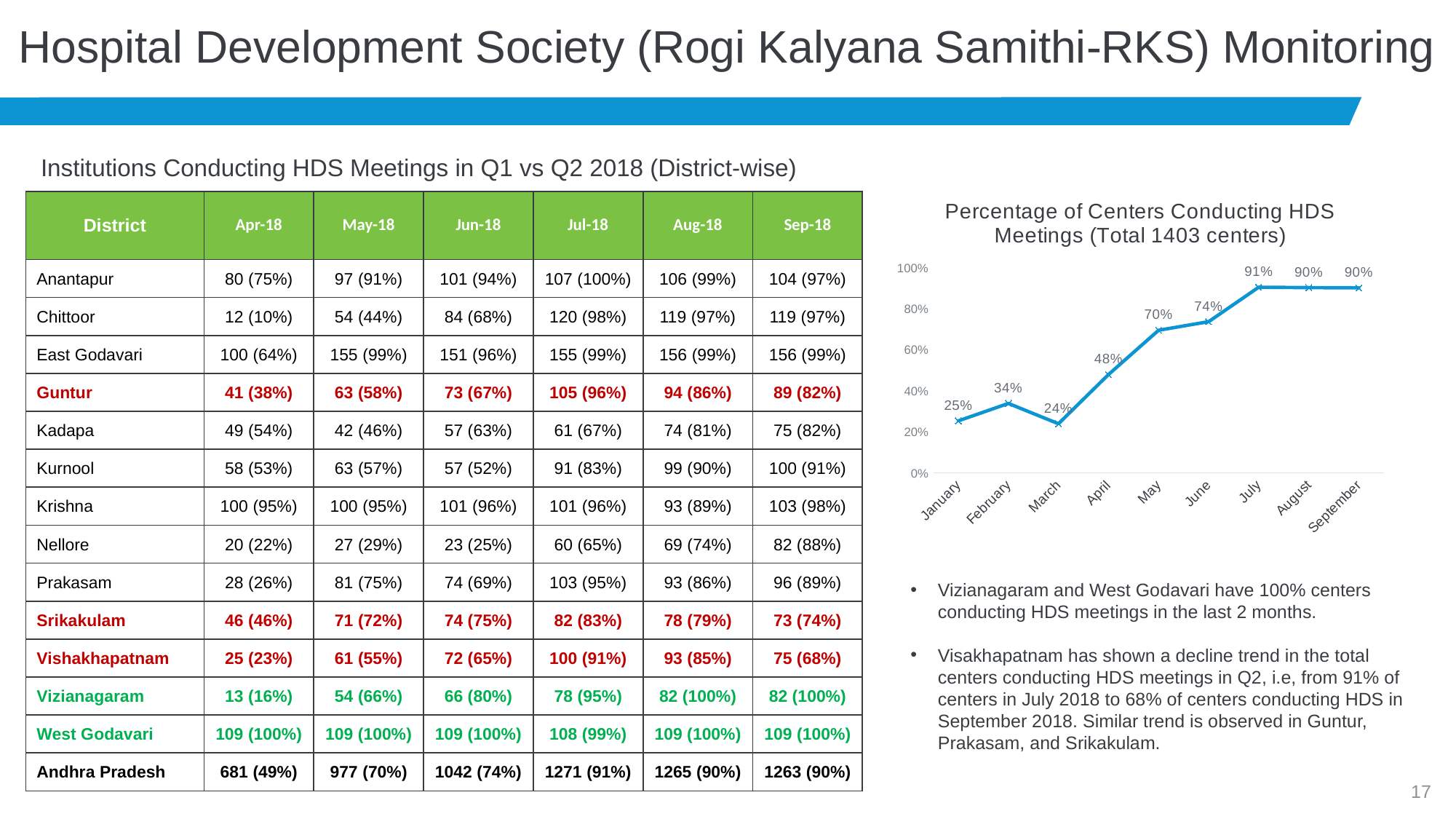
In the chart, is the percentage for May larger or the percentage for February? May In the chart, what is the difference between the percentage for March and the percentage for February? 10% How many months are plotted on the x axis of the chart? 9 Which month has the lowest percentage of centers conducting HDS meetings in the chart? March In the chart, what is the percentage of centers conducting HDS meetings in April? 48% In the chart, what is the percentage of centers conducting HDS meetings in June? 74% What is the difference between the percentage for July and the percentage for January in the chart? 66% What is the title of the chart on the slide? Percentage of Centers Conducting HDS Meetings (Total 1403 centers) In the chart, what is the percentage of centers conducting HDS meetings in January? 25% Which month has the highest percentage of centers conducting HDS meetings in the chart? July What type of chart is shown on the slide? Line chart Does the percentage of centers conducting HDS meetings generally rise or fall from January to September in the chart? Rise